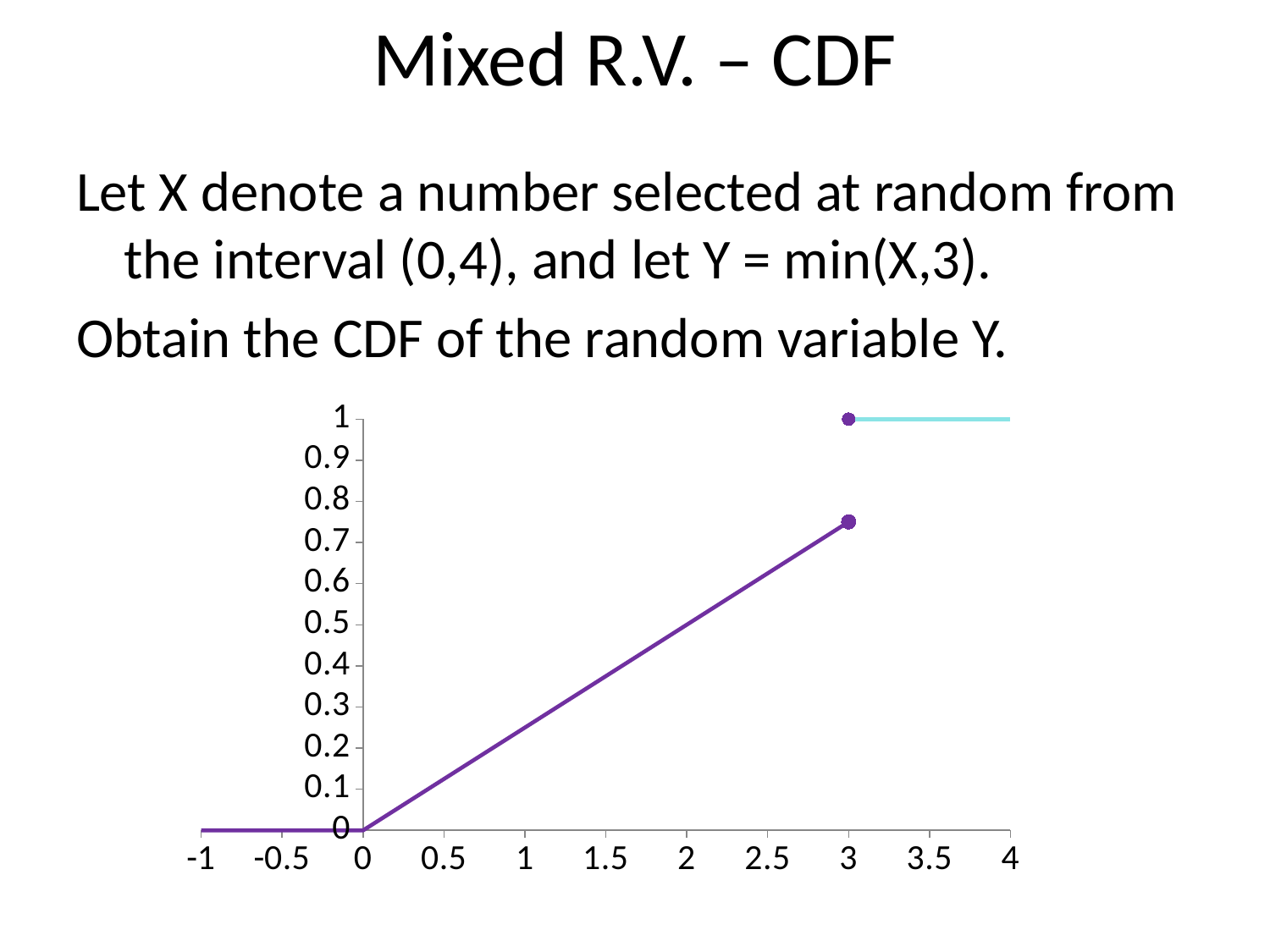
Is the value of the line at x = 1 greater or less than 0.5? less What is the lowest value shown on the x axis? -1 What is the highest value shown on the y axis? 1 Which is larger, the value of the line at x = 1 or at x = 2? x = 2 What kind of chart is shown on the slide? line chart Does the plotted line rise or fall as x increases from 0 to 3? rise Is the value of the lower marked point at x = 3 greater or less than 0.8? less Is the value of the line at x = 2 greater or less than 0.4? greater What is the value of the upper marked point at x = 3? 1 What is the value of the line at x = 4? 1 What is the value of the line at x = 0? 0